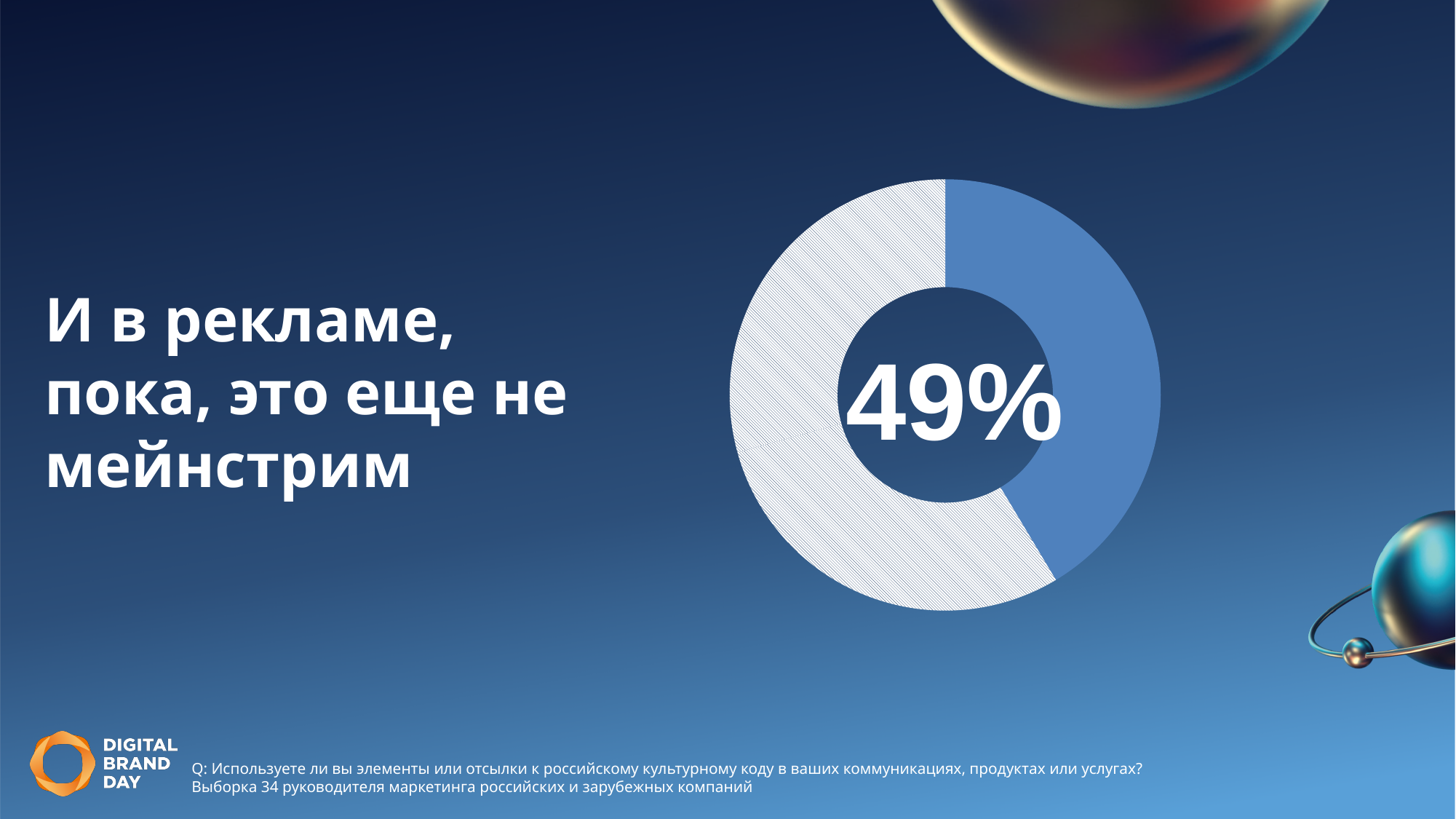
Is the value shown in the donut chart greater or less than 50%? less What kind of chart is shown on the slide? Donut (pie) chart According to the footnote, how many marketing executives were in the sample? 34 What is the headline text to the left of the chart? И в рекламе, пока, это еще не мейнстрим What percentage is printed in the centre of the donut chart? 49%